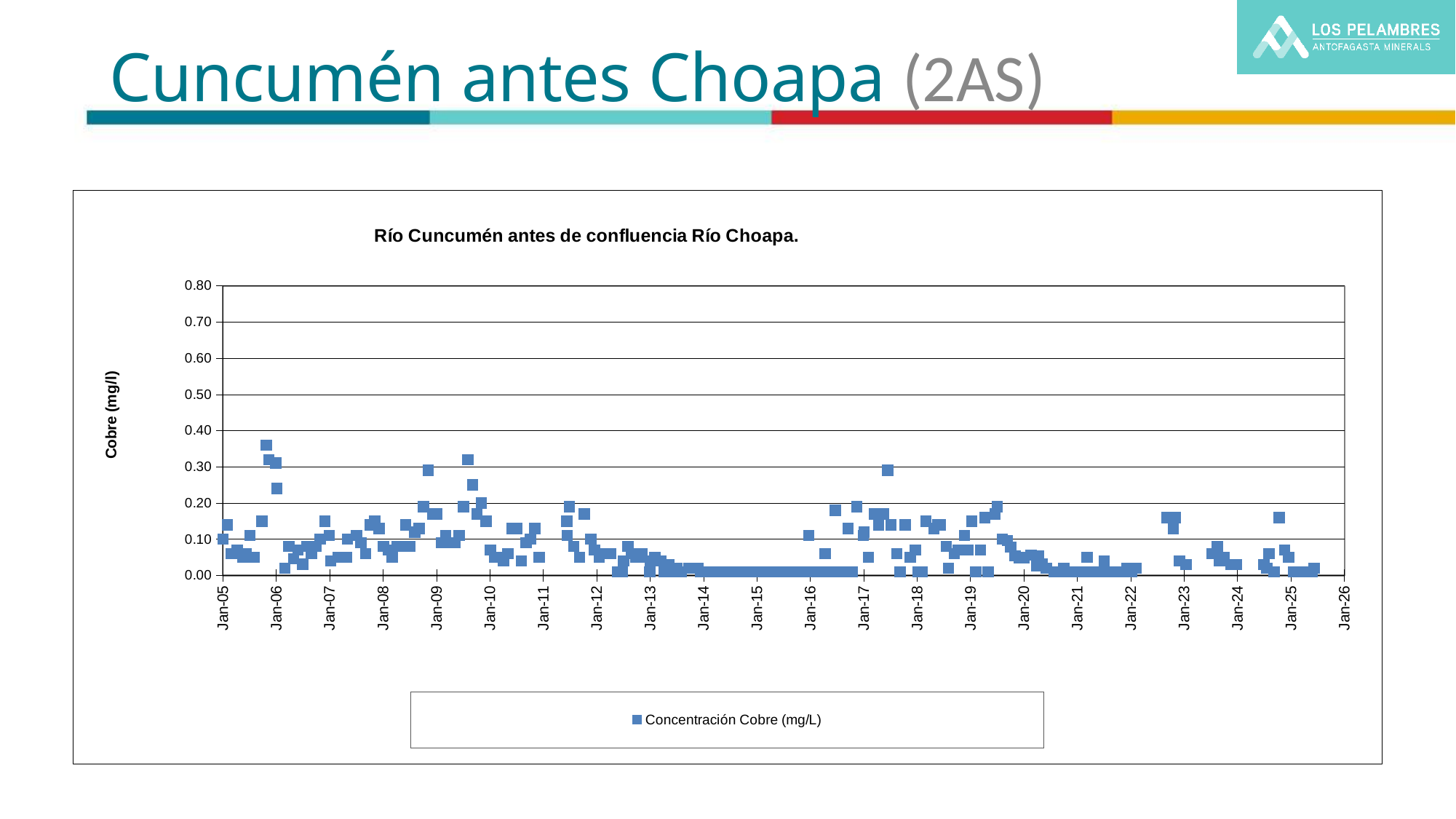
What is the first year label on the horizontal axis? Jan-05 How many series does the legend list? 1 Is the highest plotted value, near Jan-06, greater or less than 0.30? greater Do the plotted values generally rise or fall from Jan-12 to Jan-14? fall What kind of chart is shown on the slide? scatter chart What is the title of the chart? Río Cuncumén antes de confluencia Río Choapa. What series does the chart legend list? Concentración Cobre (mg/L) Are the values plotted around Jan-25 greater or less than 0.20? less Is any plotted value greater or less than 0.40? less